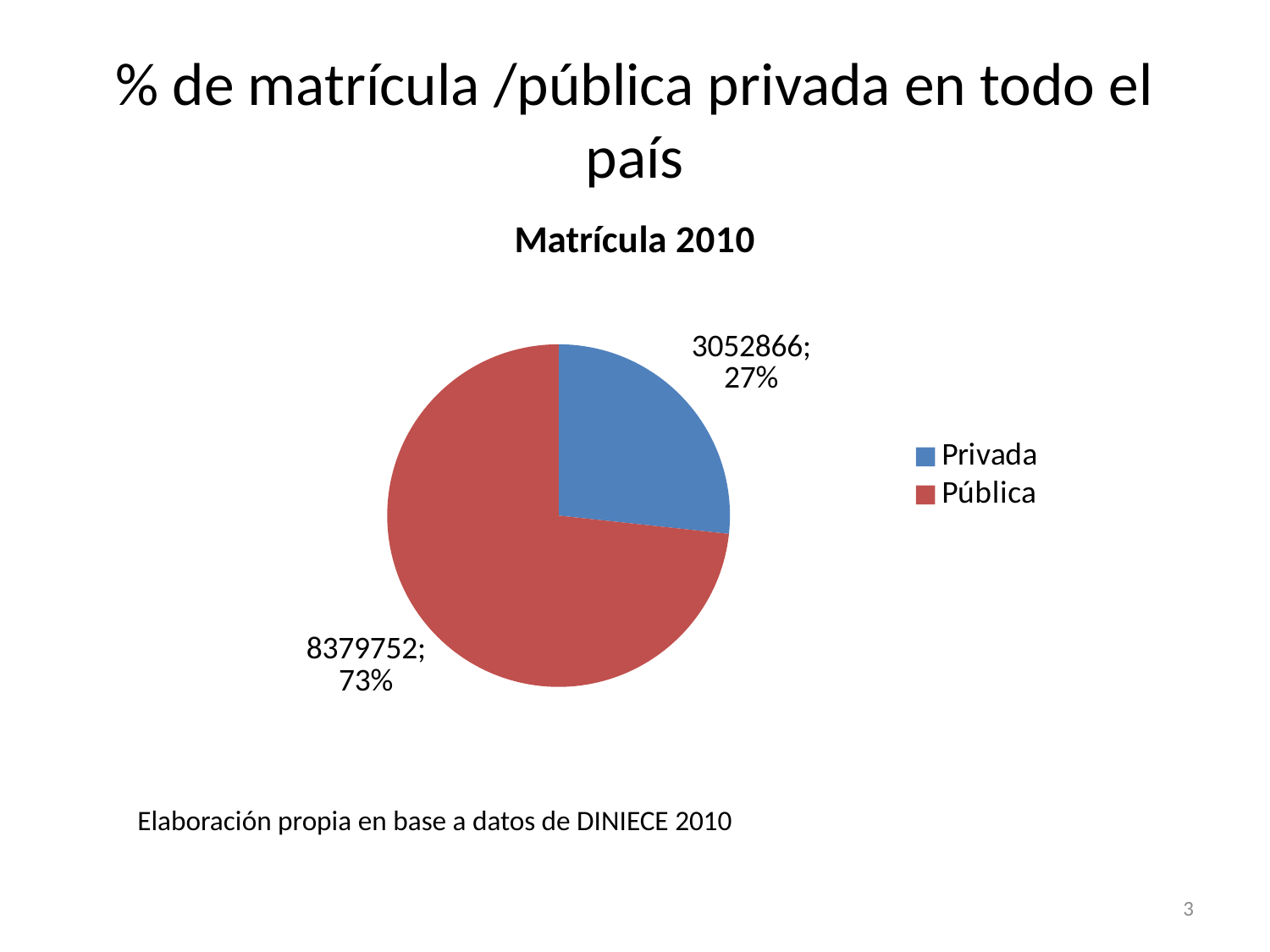
What kind of chart is shown on the slide? pie chart What is the value for Pública? 8379752 Which is larger, Privada or Pública? Pública What share of the pie does Privada represent? 27% What colour is the Pública slice? red What is the chart's title? Matrícula 2010 What share of the pie does Pública represent? 73% How many slices does the pie chart have? 2 What is the value for Privada? 3052866 Which category has the largest slice? Pública What is the difference between the values for Pública and Privada? 5326886 Which category has the smallest slice? Privada